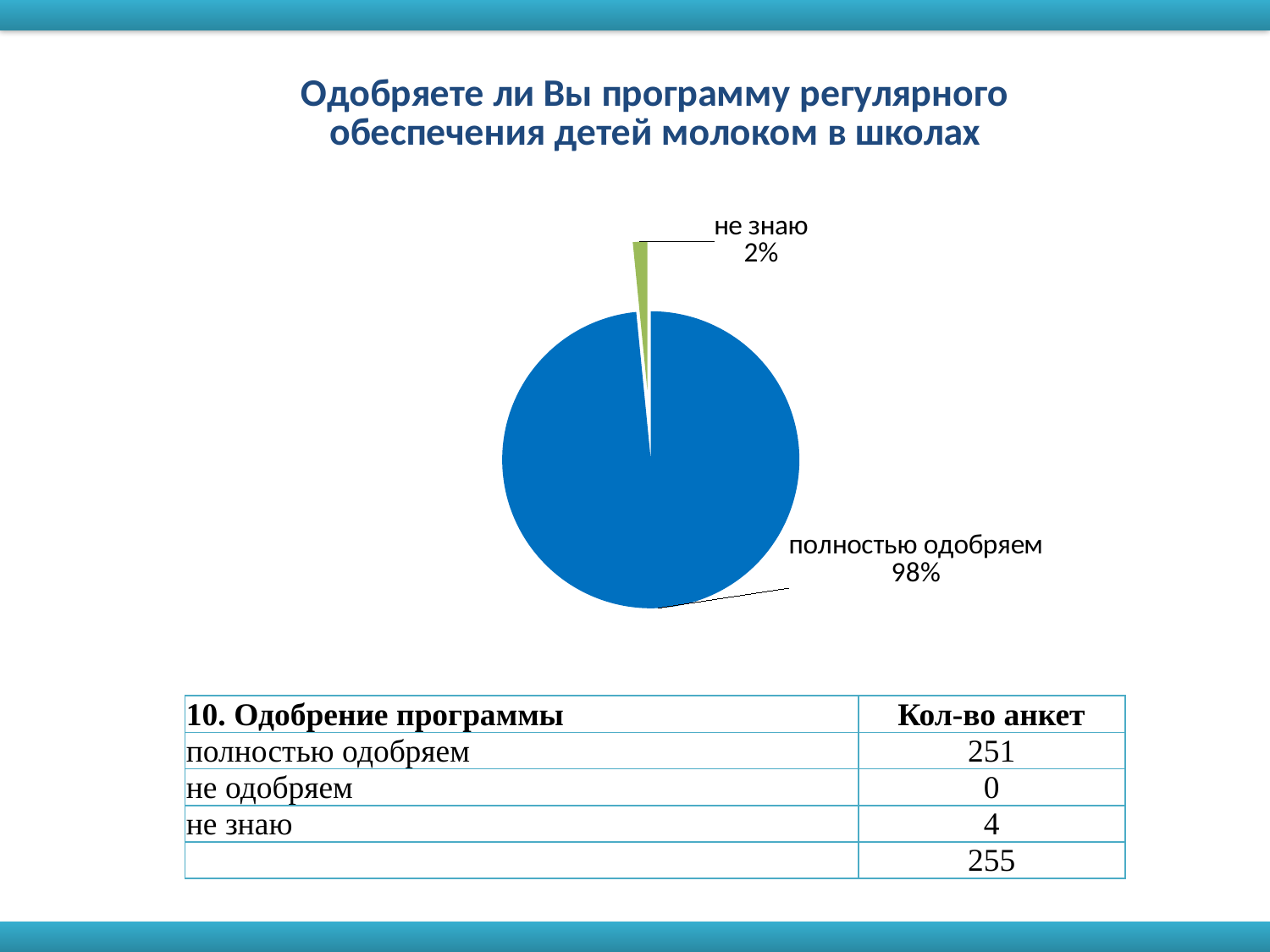
What share of the pie does "не знаю" take? 2% How many slices does the pie chart have? 2 Which slice of the pie chart is the smallest? не знаю What kind of chart is shown on the slide? pie chart Which slice of the pie chart is the largest? полностью одобряем What share of the pie does "полностью одобряем" take? 98% What colour is the "не знаю" slice of the pie chart? green What is the title of the chart on the slide? Одобряете ли Вы программу регулярного обеспечения детей молоком в школах Which is larger, the "полностью одобряем" slice or the "не знаю" slice? полностью одобряем What is the difference in percentage points between the "полностью одобряем" slice and the "не знаю" slice? 96